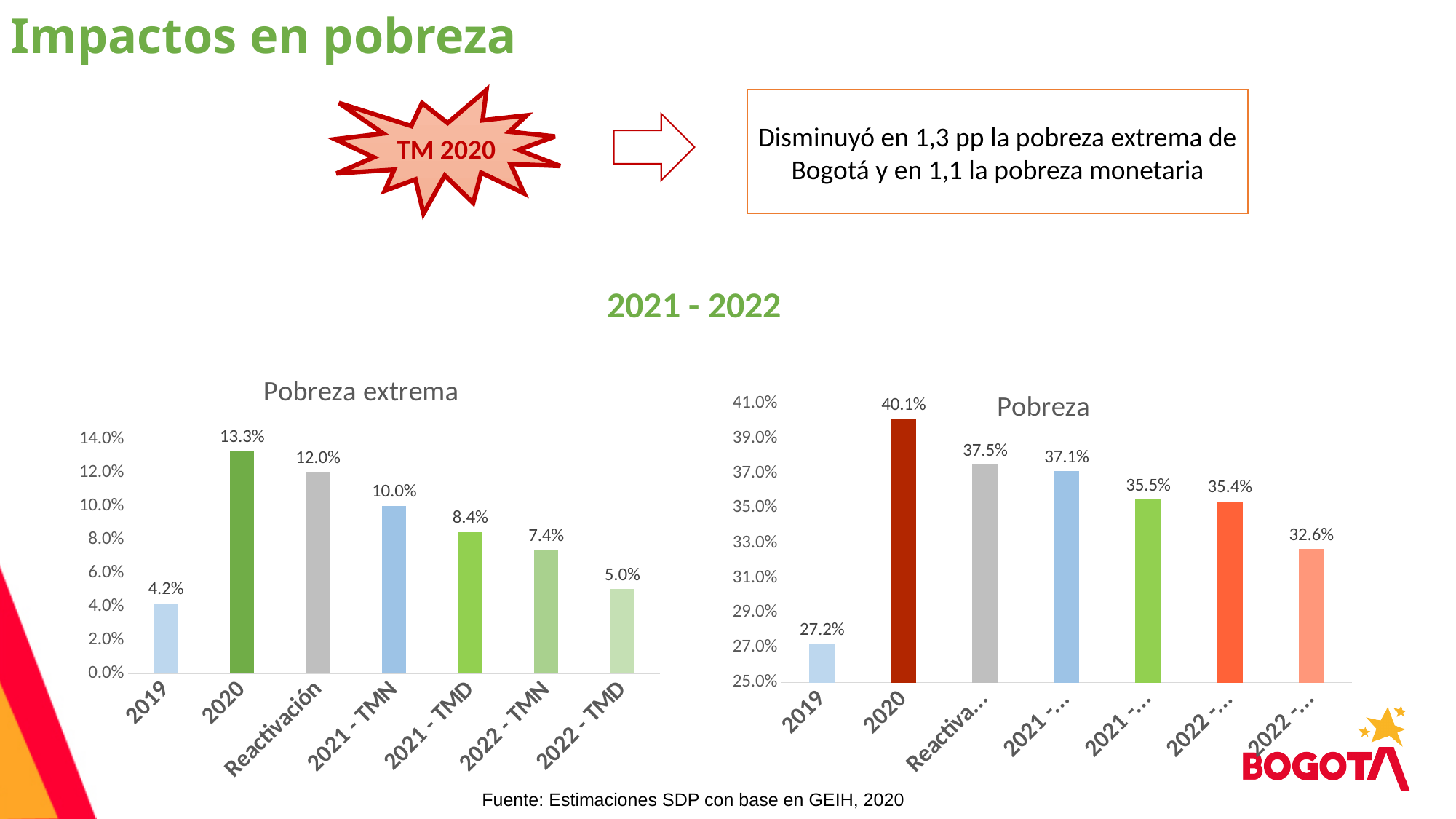
What type of chart is the 'Pobreza' chart? Bar chart In the 'Pobreza' chart, which category has the highest value? 2020 In the 'Pobreza extrema' chart, what is the difference between the values for 2021 - TMN and 2021 - TMD? 1.6% In the 'Pobreza extrema' chart, which category has the lowest value? 2019 In the 'Pobreza' chart, what is the value for 2019? 27.2% In the 'Pobreza extrema' chart, what is the value for 2022 - TMD? 5.0% In the 'Pobreza extrema' chart, what is the value for 2020? 13.3% In the 'Pobreza' chart, what is the value for 2020? 40.1% How many bars are shown in the 'Pobreza extrema' chart? 7 In the 'Pobreza' chart, what is the difference between the values for 2020 and 2019? 12.9% In the 'Pobreza extrema' chart, what is the value for Reactivación? 12.0% In the 'Pobreza extrema' chart, which is larger, the value for 2022 - TMN or the value for 2022 - TMD? 2022 - TMN